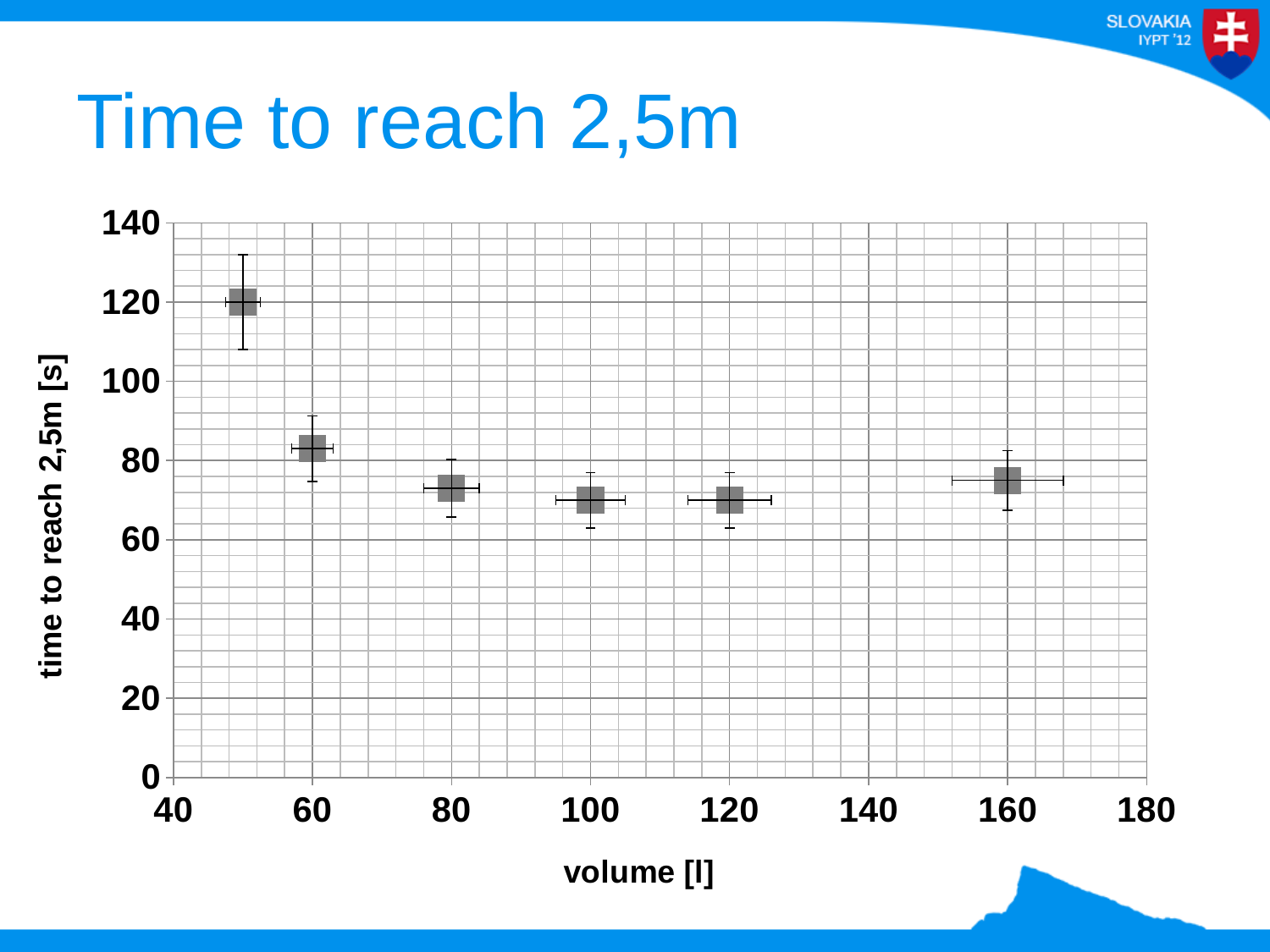
Is the time to reach 2,5m for the point at 60 l greater or less than 100? less At which volume is the time to reach 2,5m highest? 50 l Between volumes of 50 l and 100 l, does the time to reach 2,5m rise or fall as volume increases? fall Is the time to reach 2,5m for the point at 50 l greater or less than 100? greater Which has a larger time to reach 2,5m: the point at 50 l or the point at 160 l? 50 l How many data points are plotted on the chart? 6 Which has a larger time to reach 2,5m: the point at 60 l or the point at 80 l? 60 l What kind of chart is shown on the slide? scatter plot Is the time to reach 2,5m for the point at 100 l greater or less than 80? less What is the label of the x axis? volume [l] What is the title of the chart on the slide? Time to reach 2,5m